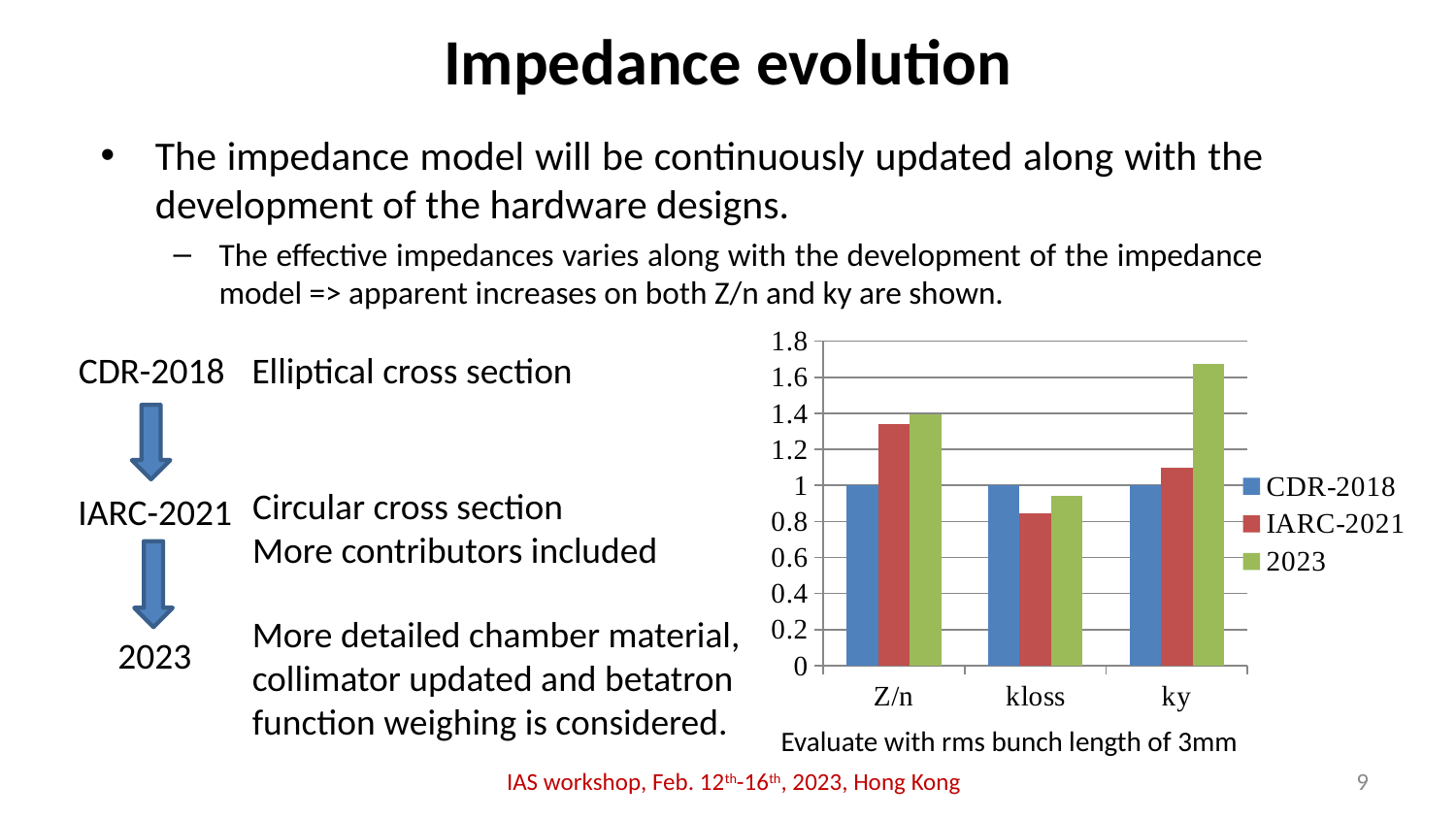
Which category has the highest value for the 2023 series? ky How many series does the chart legend list? 3 For the ky category, which series has the highest bar? 2023 Which is larger for the 2023 series: the value for Z/n or the value for ky? ky What is the value of CDR-2018 for Z/n? 1 Is the value of 2023 for ky greater or less than 1.6? greater Is the value of IARC-2021 for Z/n greater or less than 1.2? greater Is the value of IARC-2021 for kloss greater or less than 1? less How many categories are shown on the x axis of the chart? 3 For the kloss category, which series has the lowest bar? IARC-2021 What kind of chart is shown on the slide? bar chart What are the series names listed in the chart legend? CDR-2018, IARC-2021, 2023